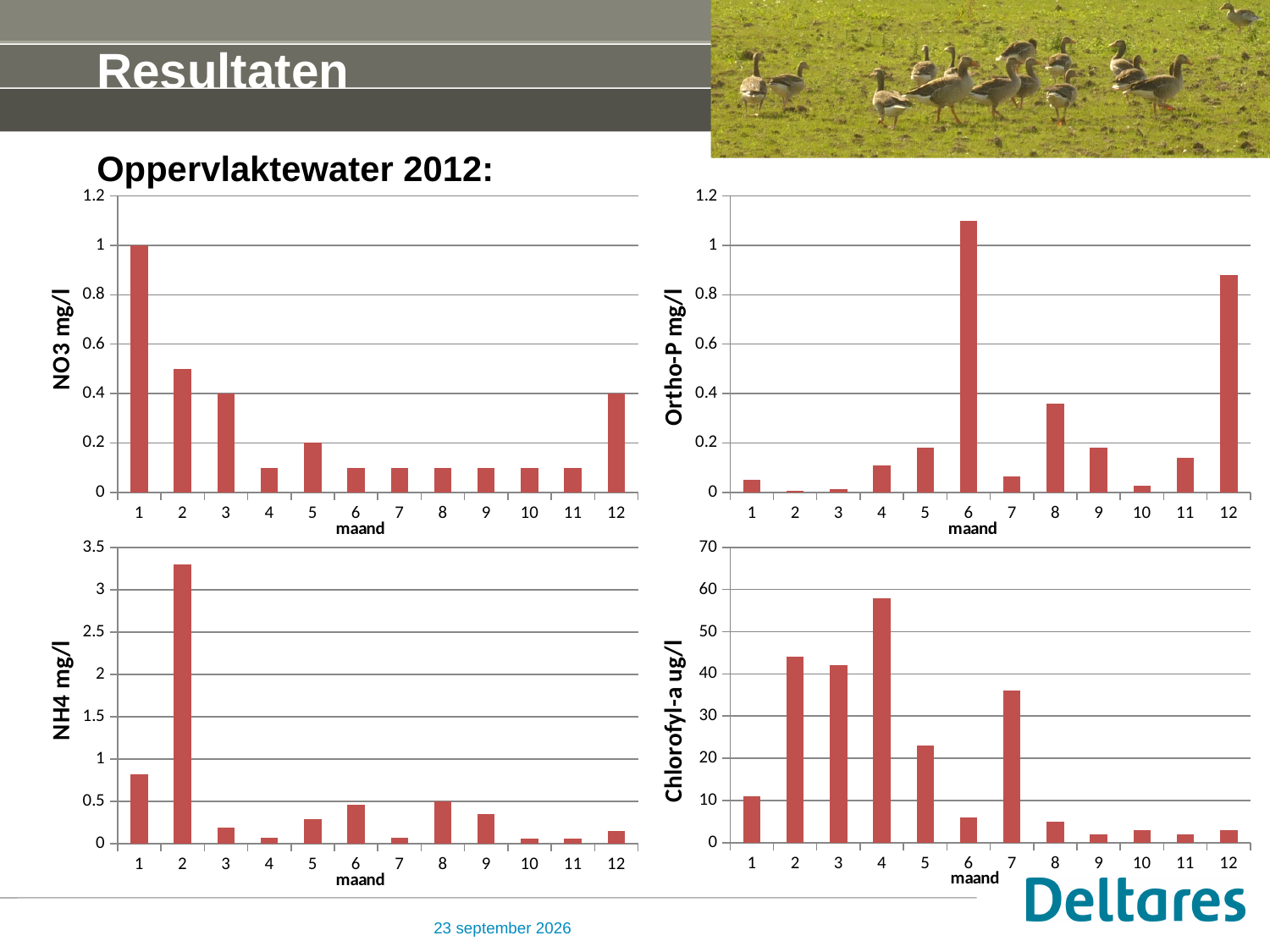
In the Chlorofyl-a ug/l chart, which maand has the highest value? 4 In the NO3 mg/l chart, what is the value for maand 1? 1 In the NO3 mg/l chart, what is the value for maand 5? 0.2 In the Ortho-P mg/l chart, which maand has the highest value? 6 In the NH4 mg/l chart, is the value for maand 2 greater or less than 3? greater In the NO3 mg/l chart, which maand has the highest value? 1 What kind of chart is the Chlorofyl-a ug/l chart? bar chart In the Chlorofyl-a ug/l chart, is the value for maand 7 greater or less than 30? greater In the Chlorofyl-a ug/l chart, which is larger, the value for maand 2 or maand 5? maand 2 How many maand categories are shown on the x axis of the NO3 mg/l chart? 12 In the Ortho-P mg/l chart, is the value for maand 12 greater or less than 0.8? greater